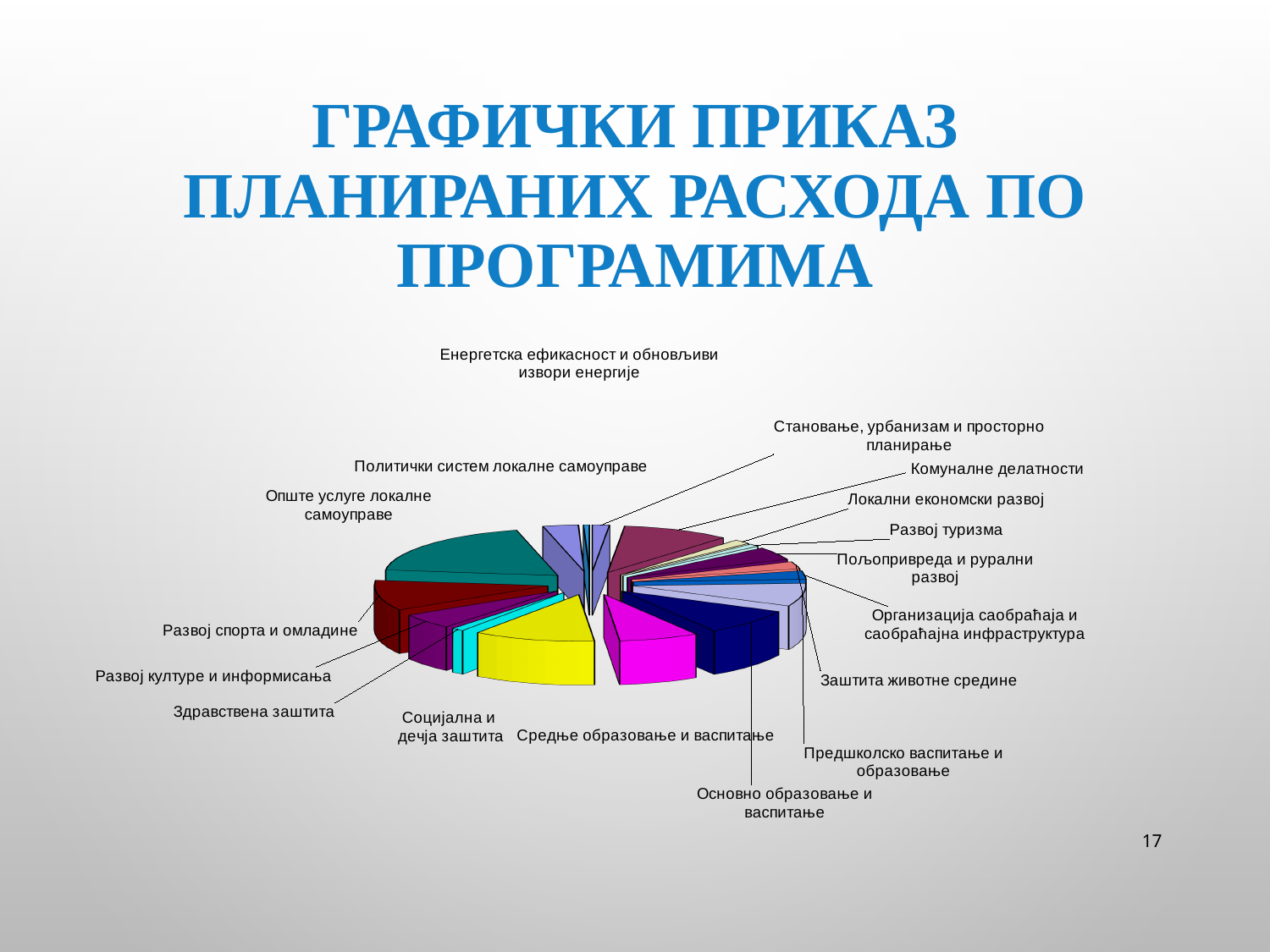
Which slice is larger: Социјална и дечја заштита or Здравствена заштита? Социјална и дечја заштита Which slice is larger: Опште услуге локалне самоуправе or Развој туризма? Опште услуге локалне самоуправе Which slice is larger: Основно образовање и васпитање or Енергетска ефикасност и обновљиви извори енергије? Основно образовање и васпитање How many program categories are labelled on the pie chart? 17 Which colour is the slice for Социјална и дечја заштита? Yellow What kind of chart is shown on the slide? Pie chart What is the title of the slide containing the pie chart? ГРАФИЧКИ ПРИКАЗ ПЛАНИРАНИХ РАСХОДА ПО ПРОГРАМИМА